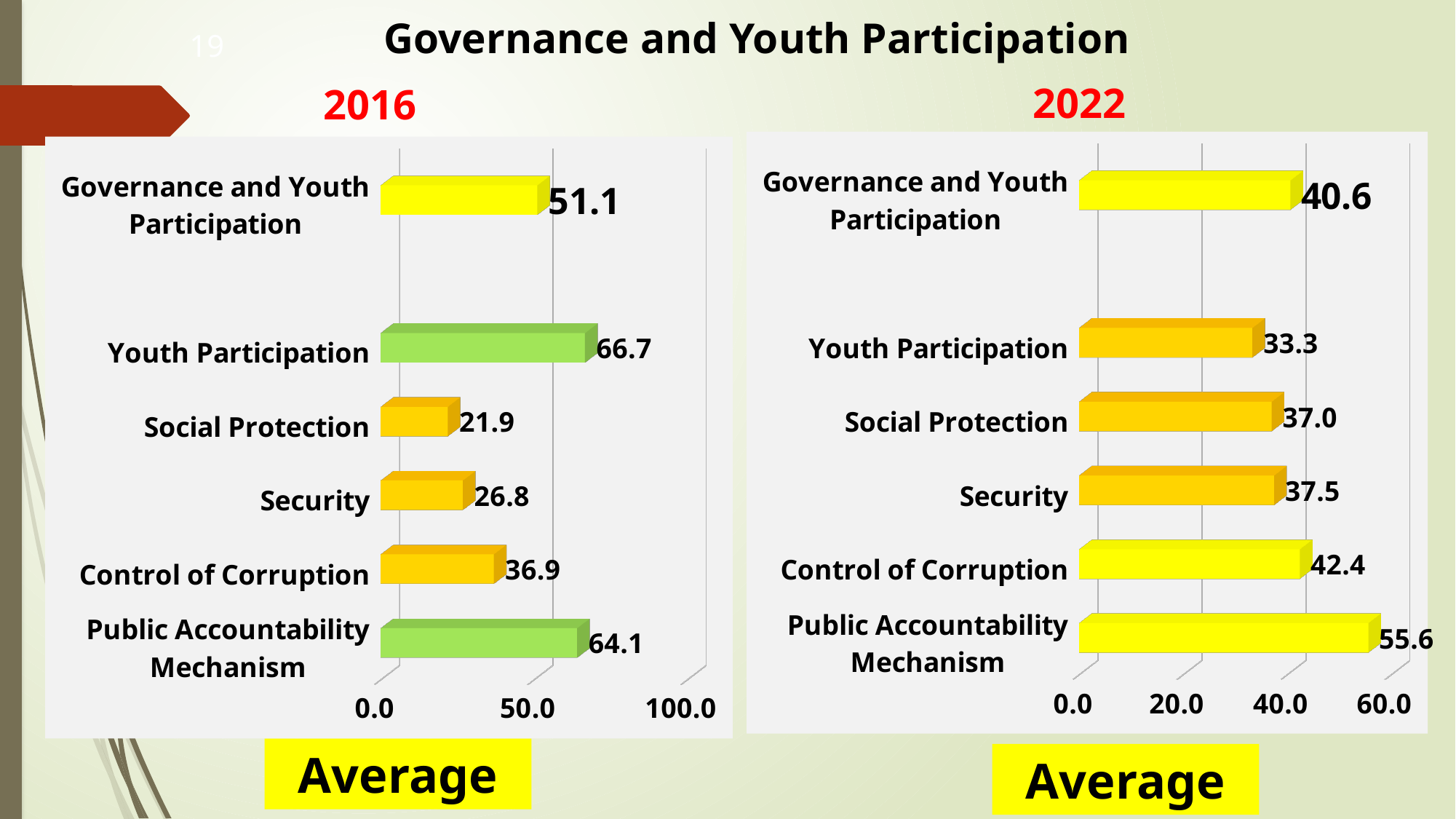
In the 2022 chart, what is the value for Public Accountability Mechanism? 55.6 What type of chart is the 2016 chart? Bar chart In the 2016 chart, what is the difference between Youth Participation and Social Protection? 44.8 In the 2016 chart, which category has the lowest value? Social Protection In the 2022 chart, what is the difference between Control of Corruption and Youth Participation? 9.1 In the 2016 chart, which is larger: Control of Corruption or Security? Control of Corruption In the 2016 chart, what is the value for Governance and Youth Participation? 51.1 In the 2016 chart, what is the value for Youth Participation? 66.7 How many categories are shown in the 2022 chart? 6 In the 2022 chart, which category has the lowest value? Youth Participation In the 2022 chart, which category has the highest value? Public Accountability Mechanism In the 2022 chart, what is the value for Security? 37.5